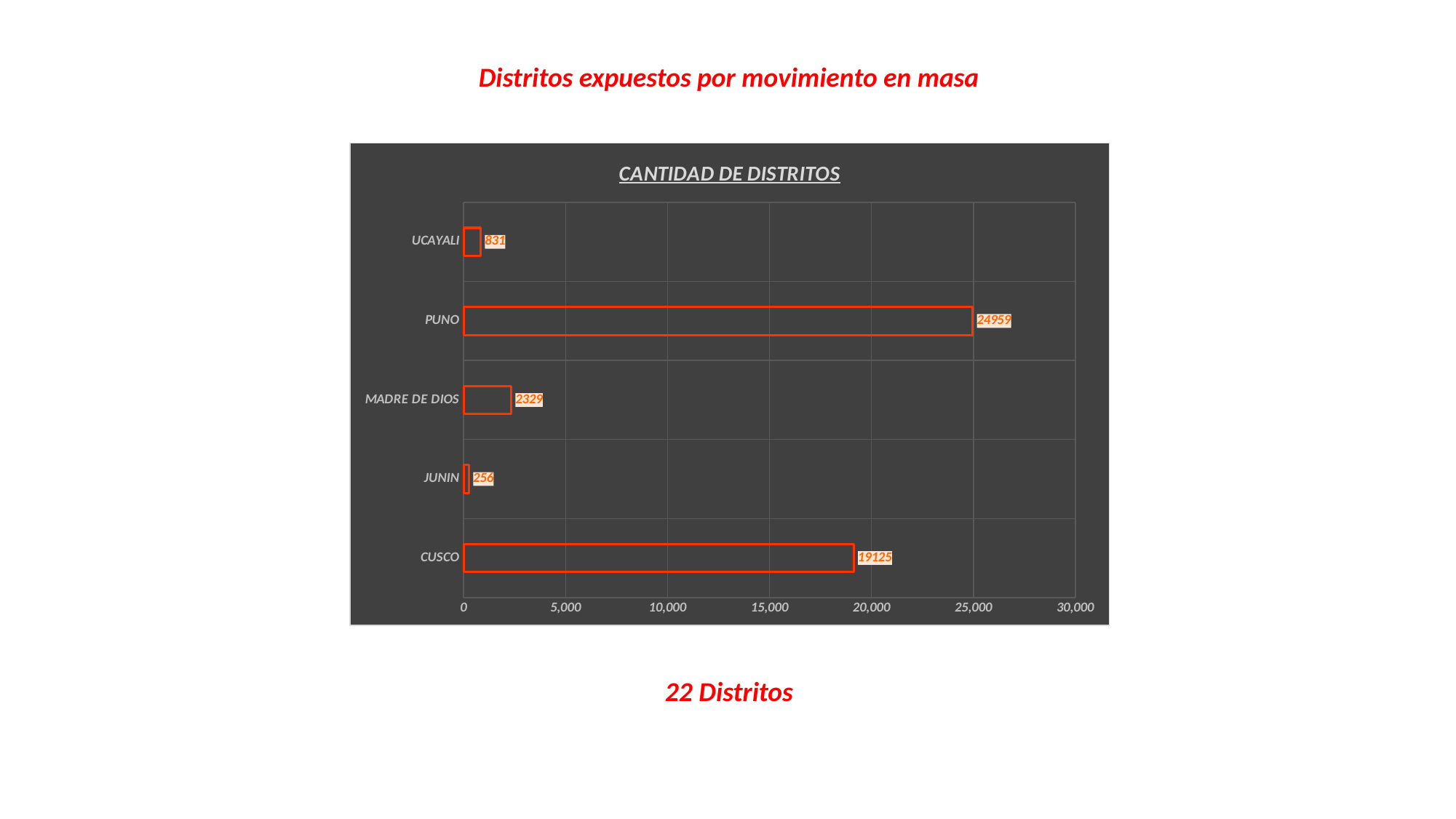
What is the value for PUNO? 24959 What is the value for CUSCO? 19125 What is the title of the chart? CANTIDAD DE DISTRITOS What is the value for UCAYALI? 831 What is the difference between the values for PUNO and CUSCO? 5834 Which is larger, the value for MADRE DE DIOS or the value for UCAYALI? MADRE DE DIOS Which category has the lowest value? JUNIN Is the value for CUSCO greater or less than 20,000? less Which category has the highest value? PUNO How many categories are shown in the chart? 5 What kind of chart is shown? bar chart What is the value for MADRE DE DIOS? 2329